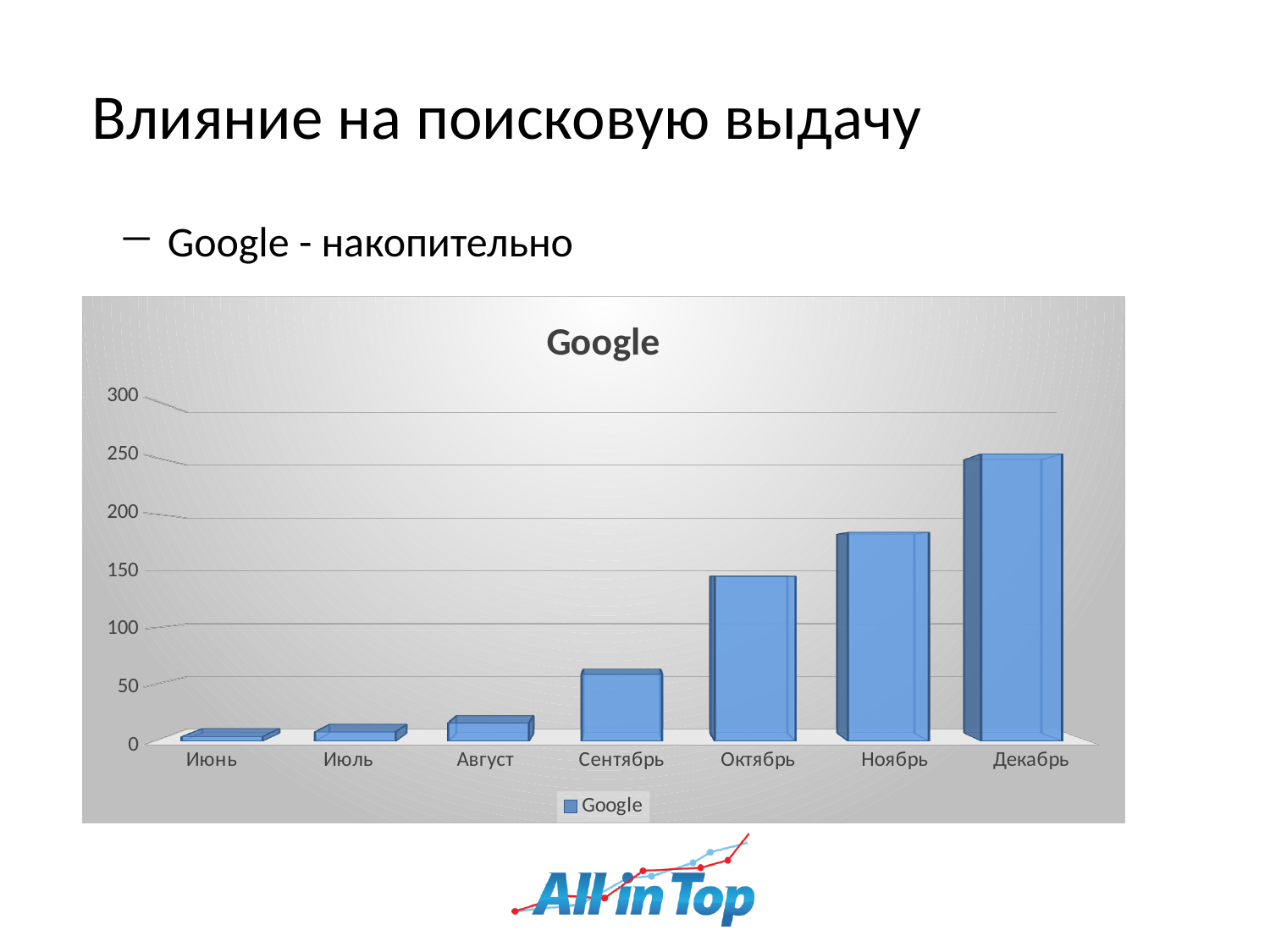
What is the title of the chart? Google How many series does the chart legend list? 1 Is the value for Ноябрь greater or less than 150? greater Which month has the highest value in the chart? Декабрь Which month has the lowest value in the chart? Июнь Is the value for Декабрь greater or less than 200? greater Is the value for Сентябрь greater or less than 100? less Which is larger, the value for Октябрь or the value for Сентябрь? Октябрь What kind of chart is shown on the slide? bar chart Do the values rise or fall from Июнь to Декабрь along the x axis? rise How many categories (months) are shown on the x axis of the chart? 7